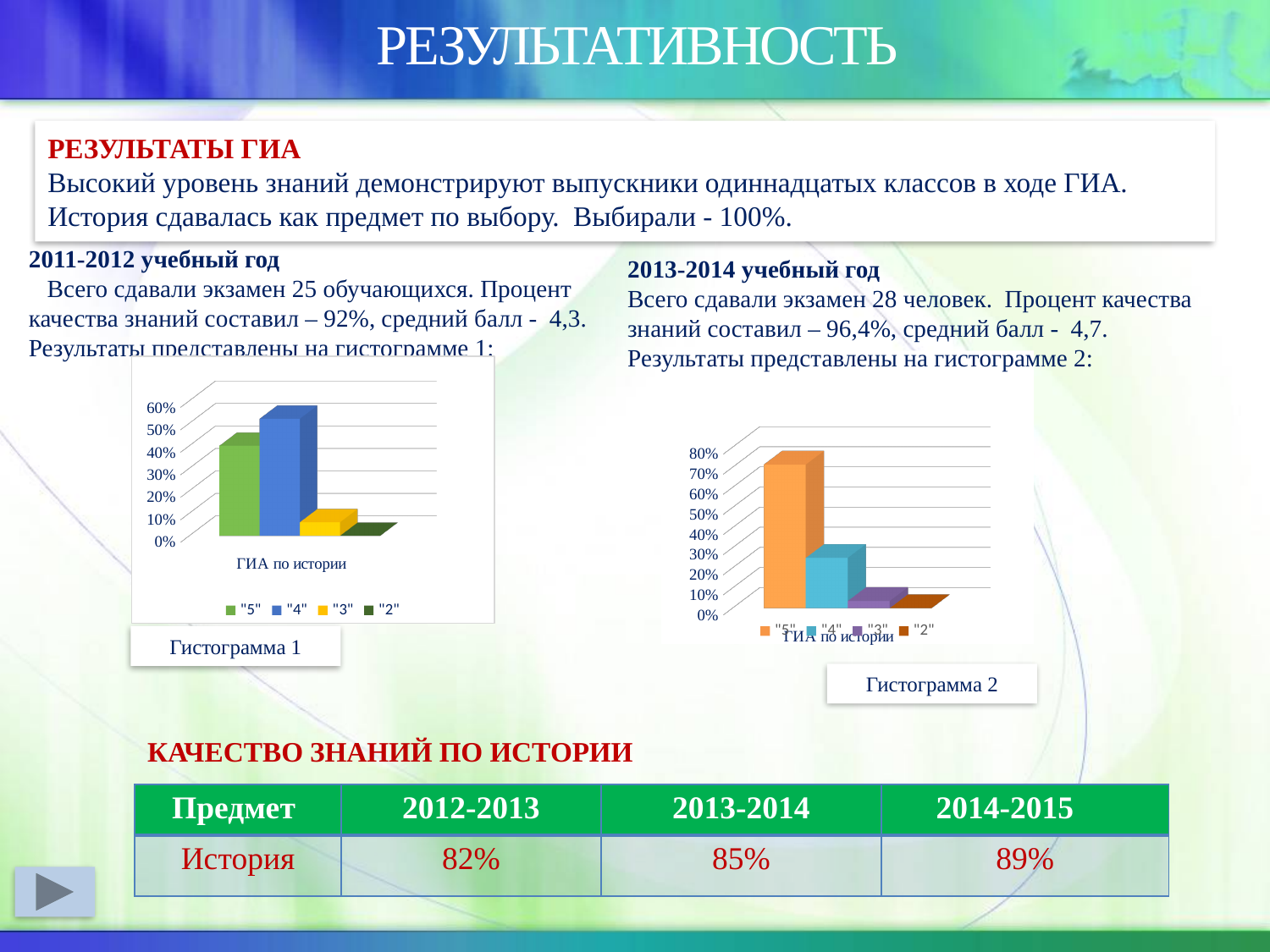
In Гистограмма 2, which is larger, the bar for "5" or the bar for "4"? "5" In Гистограмма 1, is the value for "5" greater or less than 30%? greater In Гистограмма 1, is the value for "3" greater or less than 20%? less In Гистограмма 1, which is larger, the bar for "4" or the bar for "5"? "4" In Гистограмма 1, which grade has the lowest bar? "2" What kind of chart is Гистограмма 1? bar chart What is the category label shown on the horizontal axis of Гистограмма 1? ГИА по истории In Гистограмма 2, is the value for "5" greater or less than 60%? greater How many series does the legend of Гистограмма 1 list? 4 In Гистограмма 1, which grade has the highest bar? "4" In Гистограмма 2, which grade has the highest bar? "5"